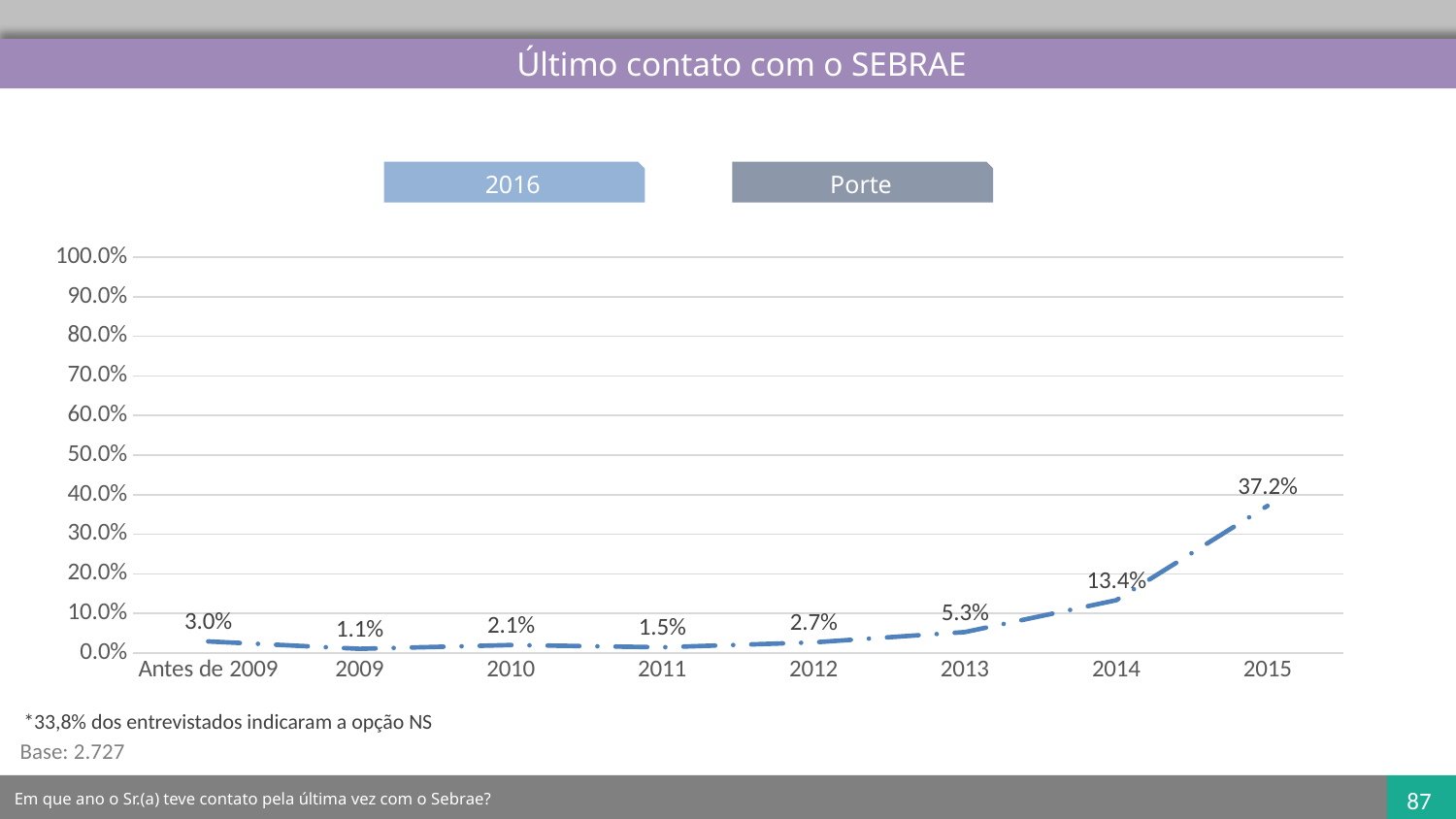
What is the value for 2011? 1.5% What is the value for 2015? 37.2% What is the title of the chart? Último contato com o SEBRAE What is the value for Antes de 2009? 3.0% Which category has the lowest value? 2009 What kind of chart is shown on the slide? line chart What is the difference between the values for 2015 and 2014? 23.8% Which is larger, the value for 2010 or the value for 2012? 2012 How many categories are shown on the x axis? 8 Is the value for 2015 greater or less than 30.0%? greater What is the value for 2014? 13.4% Which category has the highest value? 2015